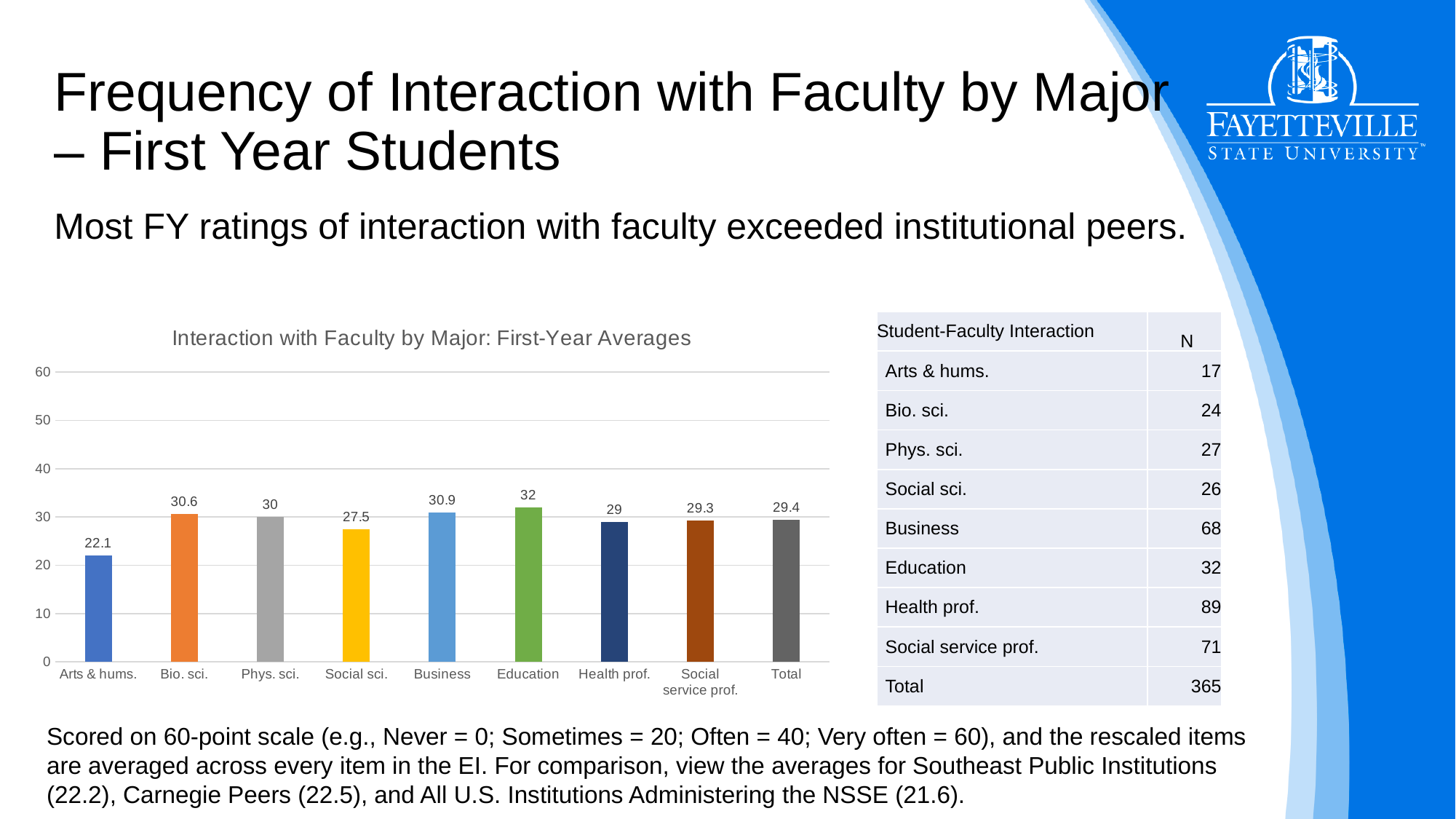
What is the value shown for Social sci. in the chart? 27.5 Is the value for Bio. sci. greater or less than 40? less Which is larger in the chart, the value for Business or the value for Health prof.? Business Which category has the lowest value in the chart? Arts & hums. What is the value shown for the Total bar in the chart? 29.4 Which major has the highest first-year average in the chart? Education What is the difference between the Education value and the Arts & hums. value? 9.9 What is the first-year average for Education in the chart? 32 How many categories are shown on the x axis of the chart? 9 What is the first-year average for Arts & hums. in the chart? 22.1 What kind of chart is shown on the slide? bar chart What is the title of the chart? Interaction with Faculty by Major: First-Year Averages